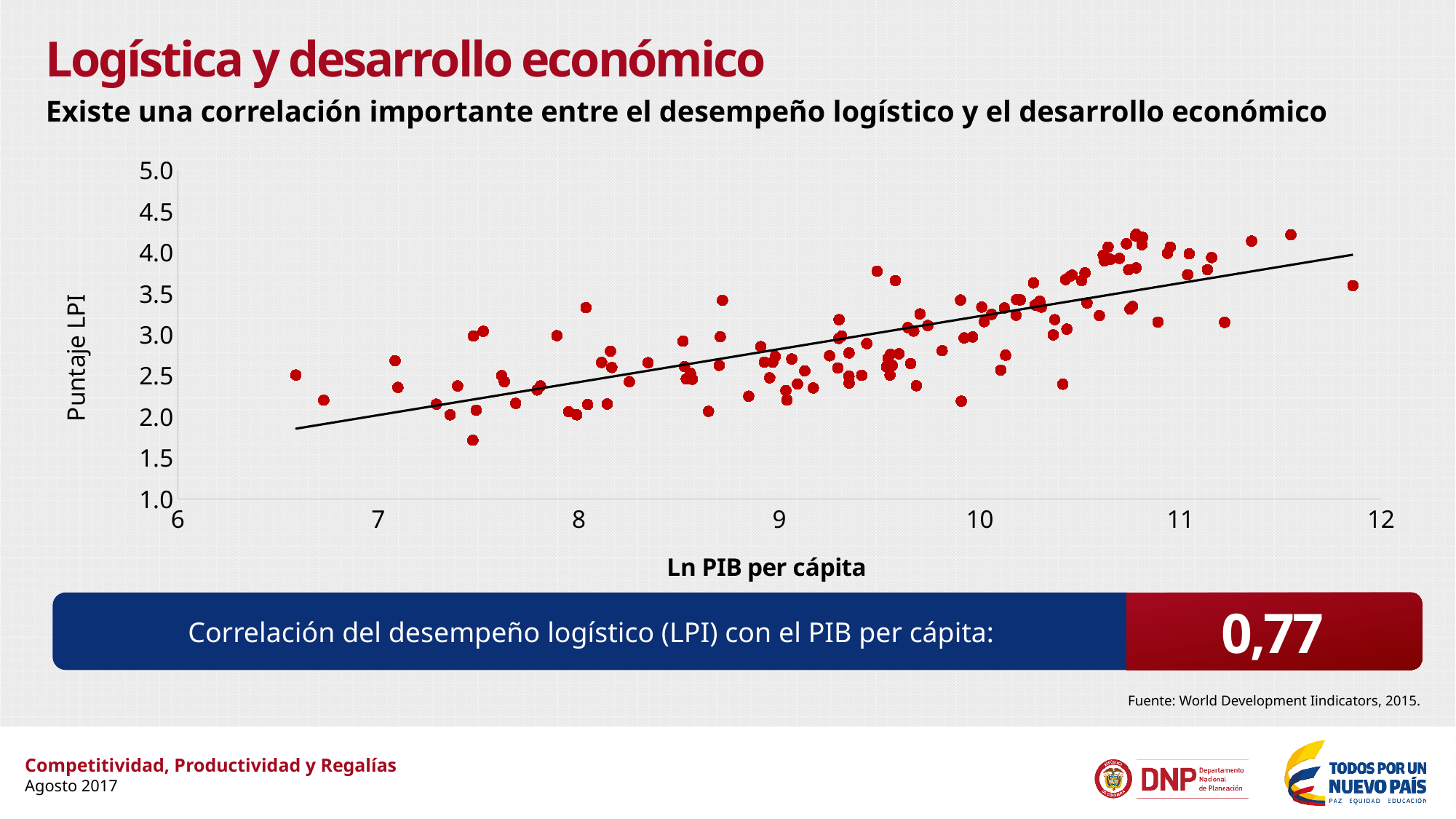
What is the label of the horizontal axis of the chart? Ln PIB per cápita Do the LPI scores generally rise or fall as Ln PIB per cápita increases along the x axis? rise Is the highest LPI score plotted on the chart greater or less than 4.0? greater Is the lowest LPI score plotted on the chart greater or less than 2.0? less What kind of chart is shown on the slide? scatter plot What is the label of the vertical axis of the chart? Puntaje LPI